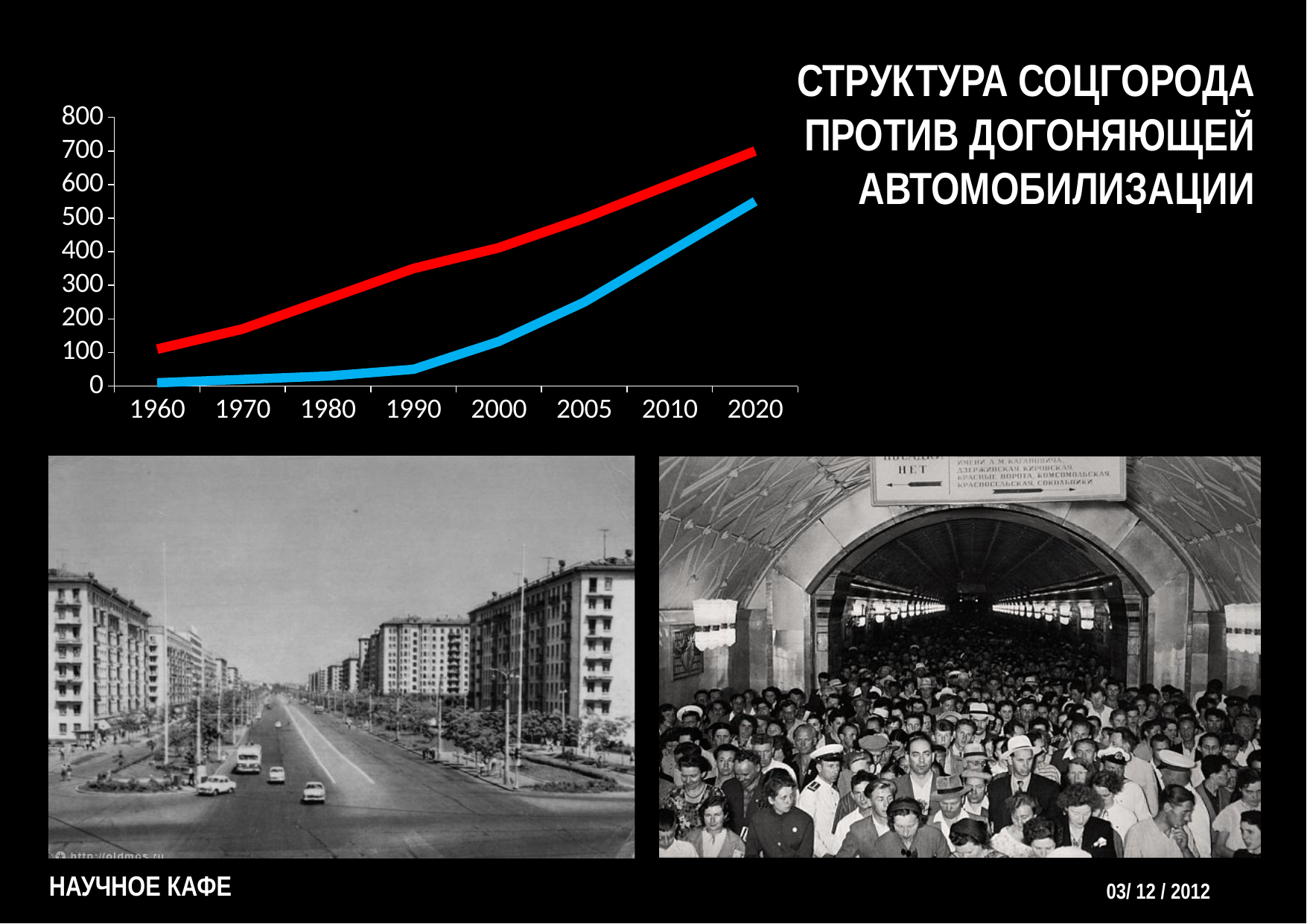
How many lines are plotted on the chart? 2 Is the value of the blue line in 1990 greater or less than 100? less Is the value of the blue line in 2020 greater or less than 500? greater Is the value of the red line in 1990 greater or less than 300? greater Does the red line rise or fall from 1960 to 2020? rise What kind of chart is shown on the slide? line chart How many years are labelled on the x axis of the chart? 8 Does the blue line rise or fall from 1960 to 2020? rise In 2000, which line has the higher value, the red or the blue? red What is the highest value shown on the y axis of the chart? 800 What are the colours of the two lines on the chart? red and blue